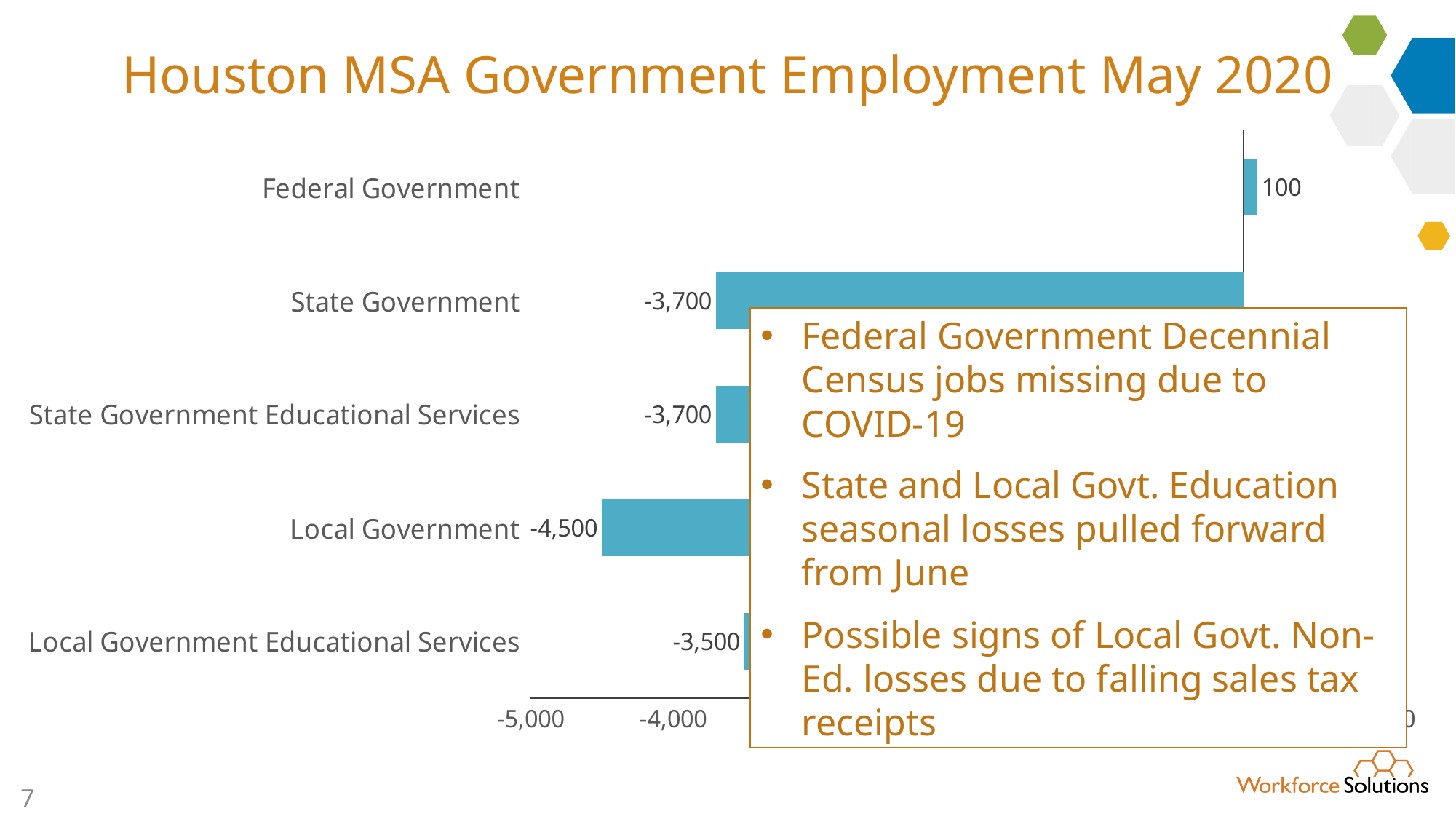
What is the value for Local Government? -4,500 What is the value for Federal Government? 100 What is the value for Local Government Educational Services? -3,500 What is the value for State Government? -3,700 What is the title of the slide containing the chart? Houston MSA Government Employment May 2020 Which category has the lowest value? Local Government How many categories are shown in the chart? 5 Which category has the highest value? Federal Government What kind of chart is shown on the slide? Bar chart Which is larger, the value for State Government or the value for Local Government? State Government What is the difference between the values for Local Government and Local Government Educational Services? 1,000 What is the value for State Government Educational Services? -3,700